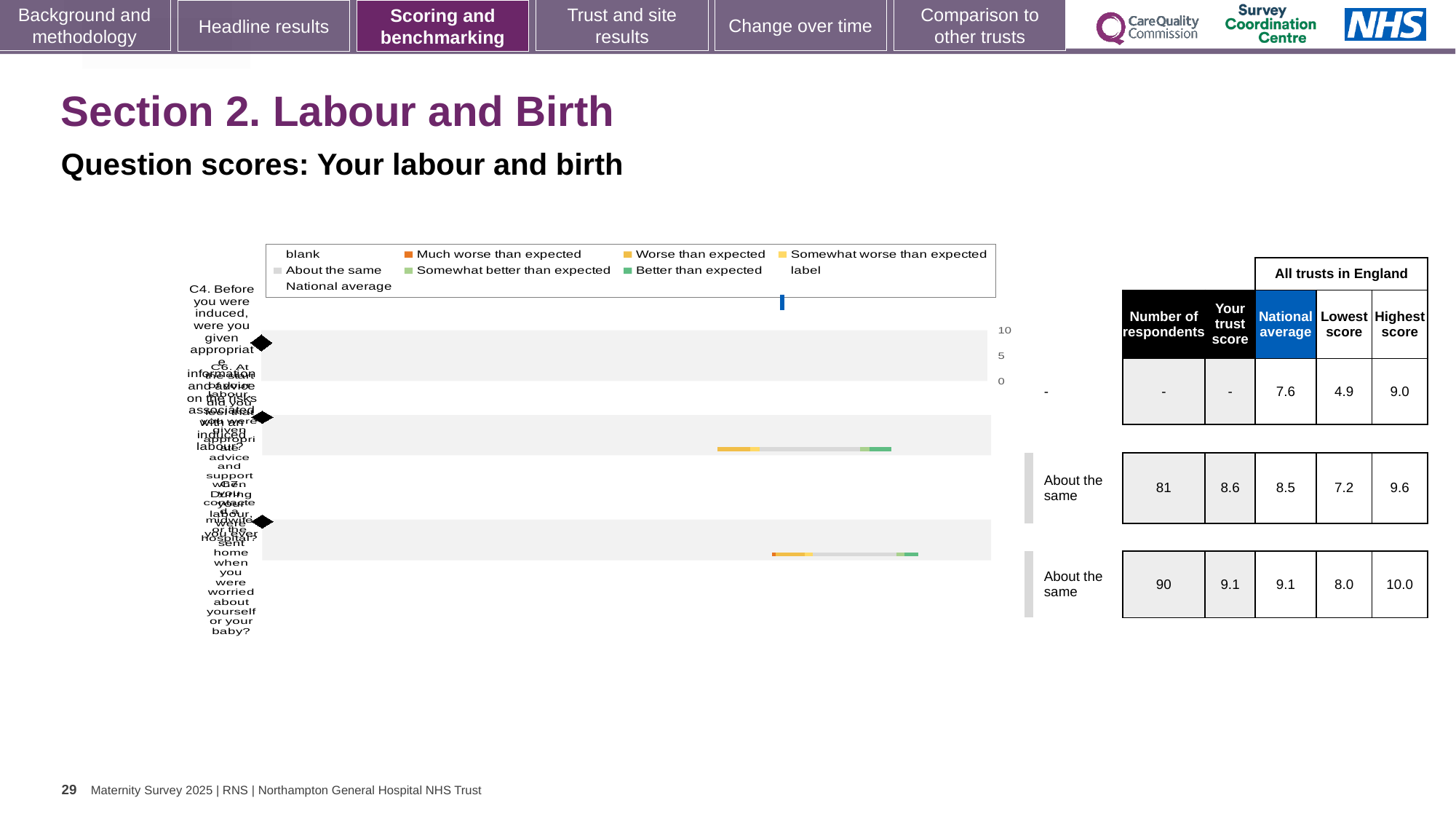
Which legend entry is shown in dark orange? Much worse than expected What is the highest value shown on the chart's numeric axis? 10 In the table next to the chart, what is the highest score in the third row? 10.0 How many entries does the chart legend list? 9 What kind of chart is shown on the slide? bar chart In the table next to the chart, what is the national average in the first row? 7.6 In the table next to the chart, what is the difference between the highest score and lowest score in the second row? 2.4 In the table next to the chart, which row has the lowest 'Lowest score' value? first row (4.9) In the table next to the chart, is the trust score in the second row larger or smaller than the national average in that row? larger In the table next to the chart, what is the difference in number of respondents between the third row and the second row? 9 In the table next to the chart, what is the trust score in the third row? 9.1 In the table next to the chart, what is the number of respondents in the second row? 81